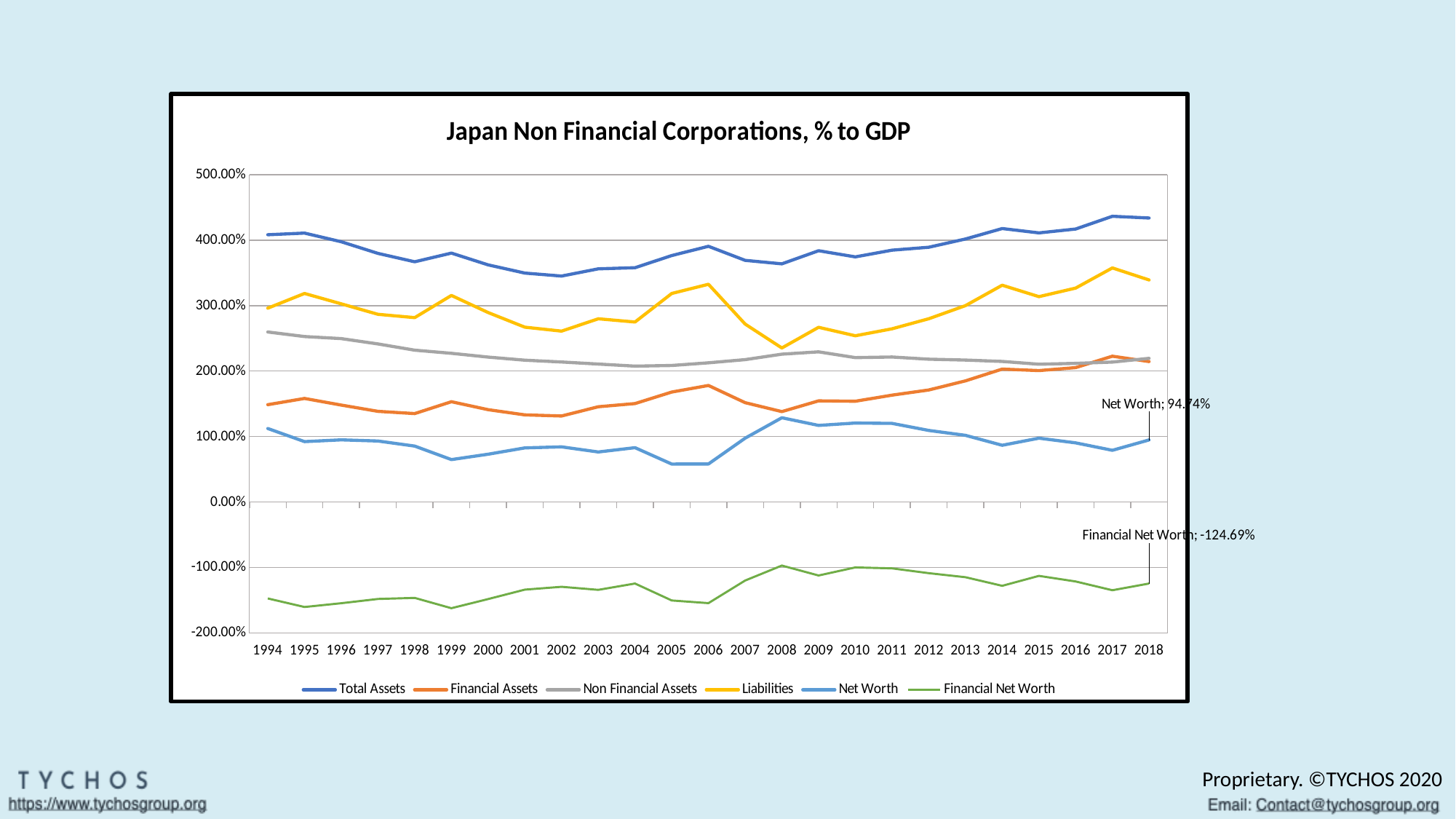
How many series does the legend list? 6 How many years are plotted along the x axis? 25 Which series has the highest values across all years? Total Assets What is the Financial Net Worth value for 2018? -124.69% Is the Financial Net Worth value for 1999 greater or less than -100.00%? less Is the Liabilities value for 2008 greater or less than 300.00%? less What is the Net Worth value for 2018? 94.74% What is the title of the chart? Japan Non Financial Corporations, % to GDP In 1994, which is larger: Financial Assets or Non Financial Assets? Non Financial Assets Is the Total Assets value for 1994 greater or less than 400.00%? greater What is the difference between Net Worth and Financial Net Worth in 2018? 219.43% What kind of chart is shown on the slide? line chart